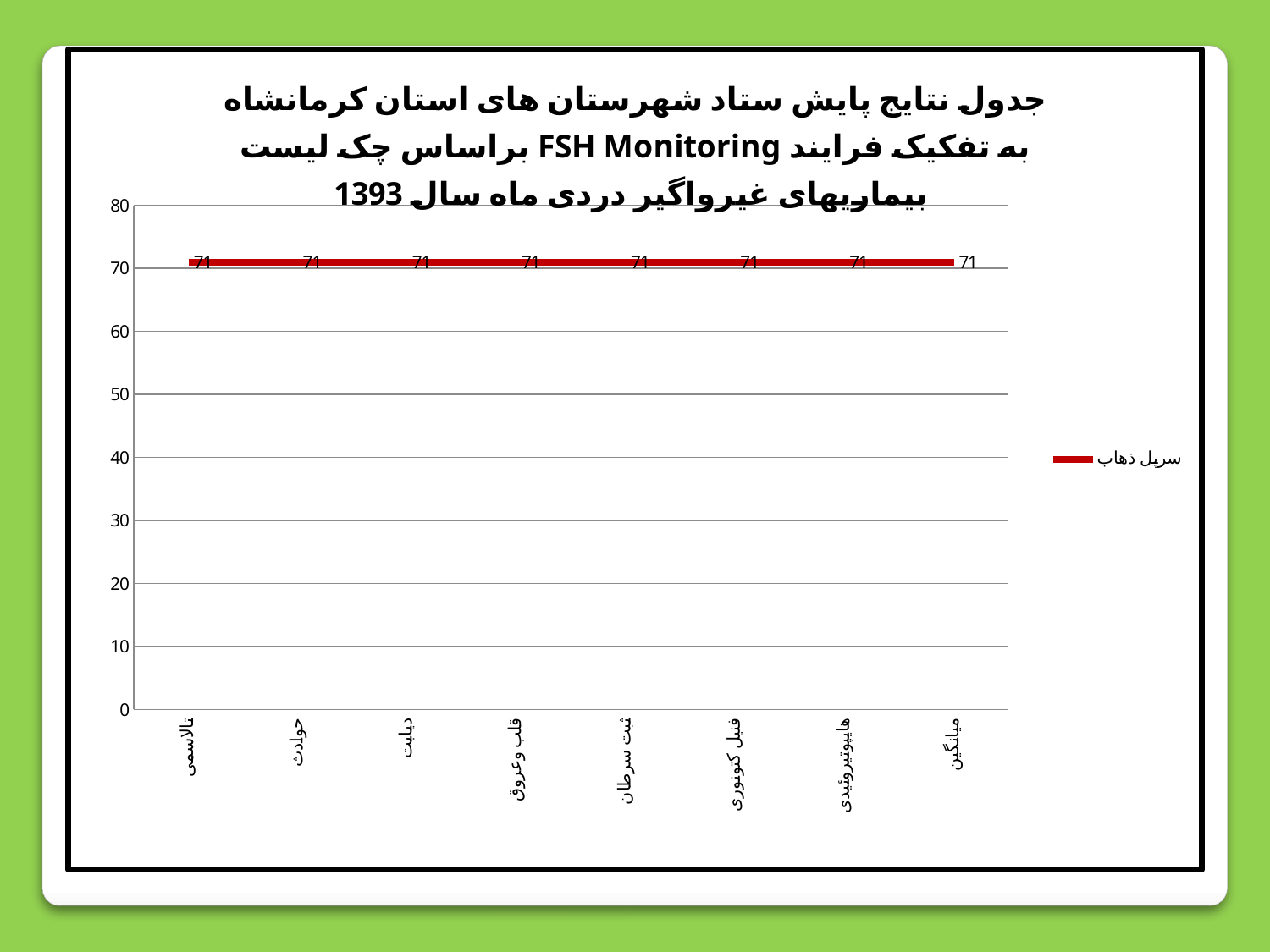
Do the values rise, fall, or stay flat across the categories along the x axis? stay flat What is the difference between the values for حوادث and ثبت سرطان? 0 What is the value for دیابت? 71 Is the value for قلب وعروق greater or less than 60? greater How many series does the legend list? 1 What is the value for تالاسمی? 71 What kind of chart is shown on the slide? line chart What is the name of the series listed in the legend? سرپل ذهاب What is the value for فنیل کتونوری? 71 Is the value for هایپوتیروئیدی greater or less than 80? less How many categories are shown on the x axis? 8 What is the value for میانگین? 71